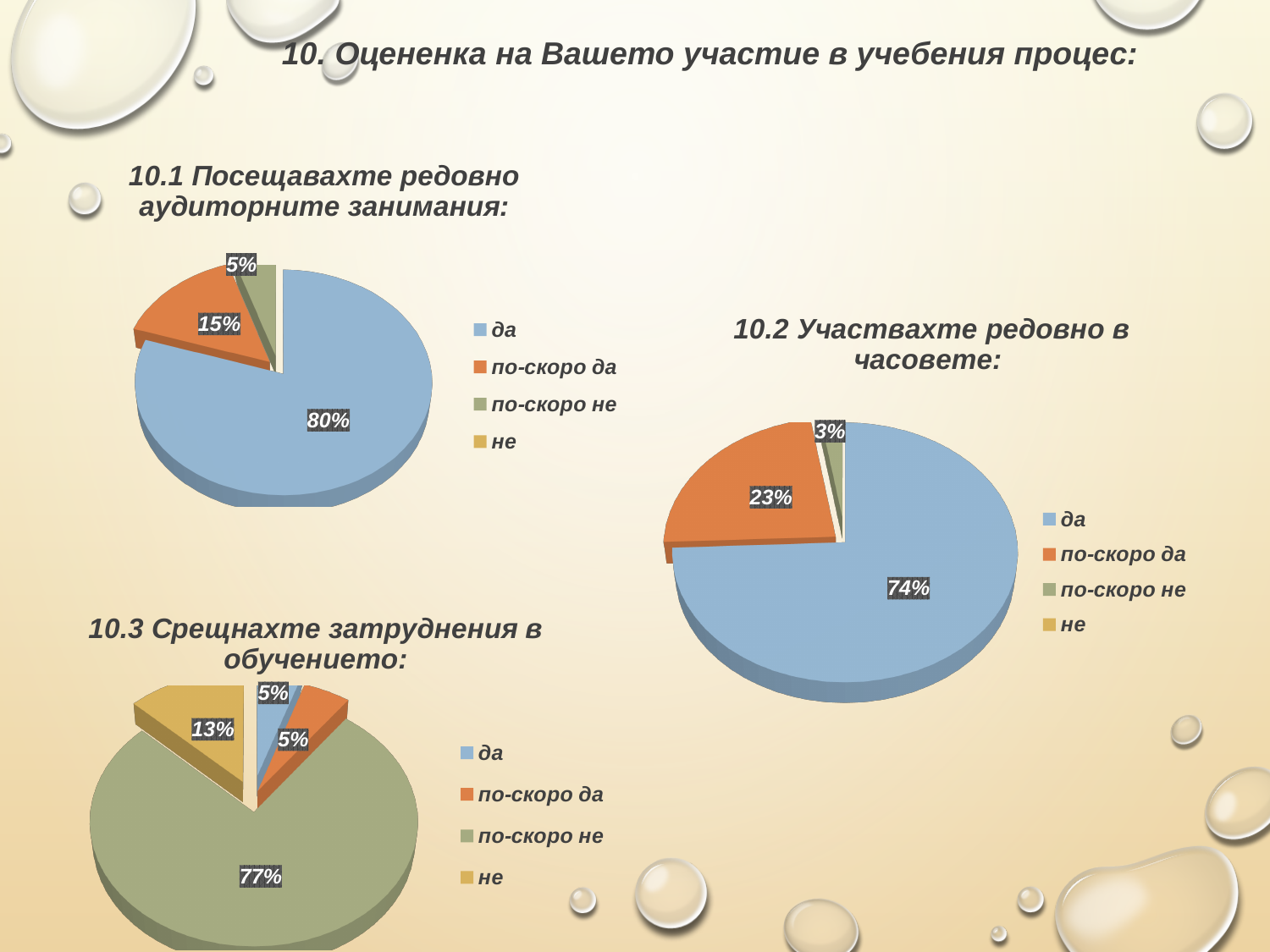
In the chart '10.2 Участвахте редовно в часовете', what is the difference between the 'да' and 'по-скоро да' slices? 51% In the chart '10.3 Срещнахте затруднения в обучението', what percentage is shown for 'по-скоро не'? 77% What type of chart is used for '10.2 Участвахте редовно в часовете'? pie chart In the chart '10.3 Срещнахте затруднения в обучението', which is larger: the 'не' slice or the 'да' slice? не In the chart '10.1 Посещавахте редовно аудиторните занимания', what percentage is shown for 'по-скоро да'? 15% In the chart '10.1 Посещавахте редовно аудиторните занимания', which category has the largest slice? да In the chart '10.3 Срещнахте затруднения в обучението', what percentage is shown for 'не'? 13% In the chart '10.2 Участвахте редовно в часовете', what percentage is shown for 'по-скоро не'? 3% In the chart '10.3 Срещнахте затруднения в обучението', which category has the largest slice? по-скоро не In the chart '10.2 Участвахте редовно в часовете', what percentage is shown for 'по-скоро да'? 23% How many entries does the legend of the chart '10.1 Посещавахте редовно аудиторните занимания' list? 4 In the chart '10.1 Посещавахте редовно аудиторните занимания', what percentage is shown for 'да'? 80%